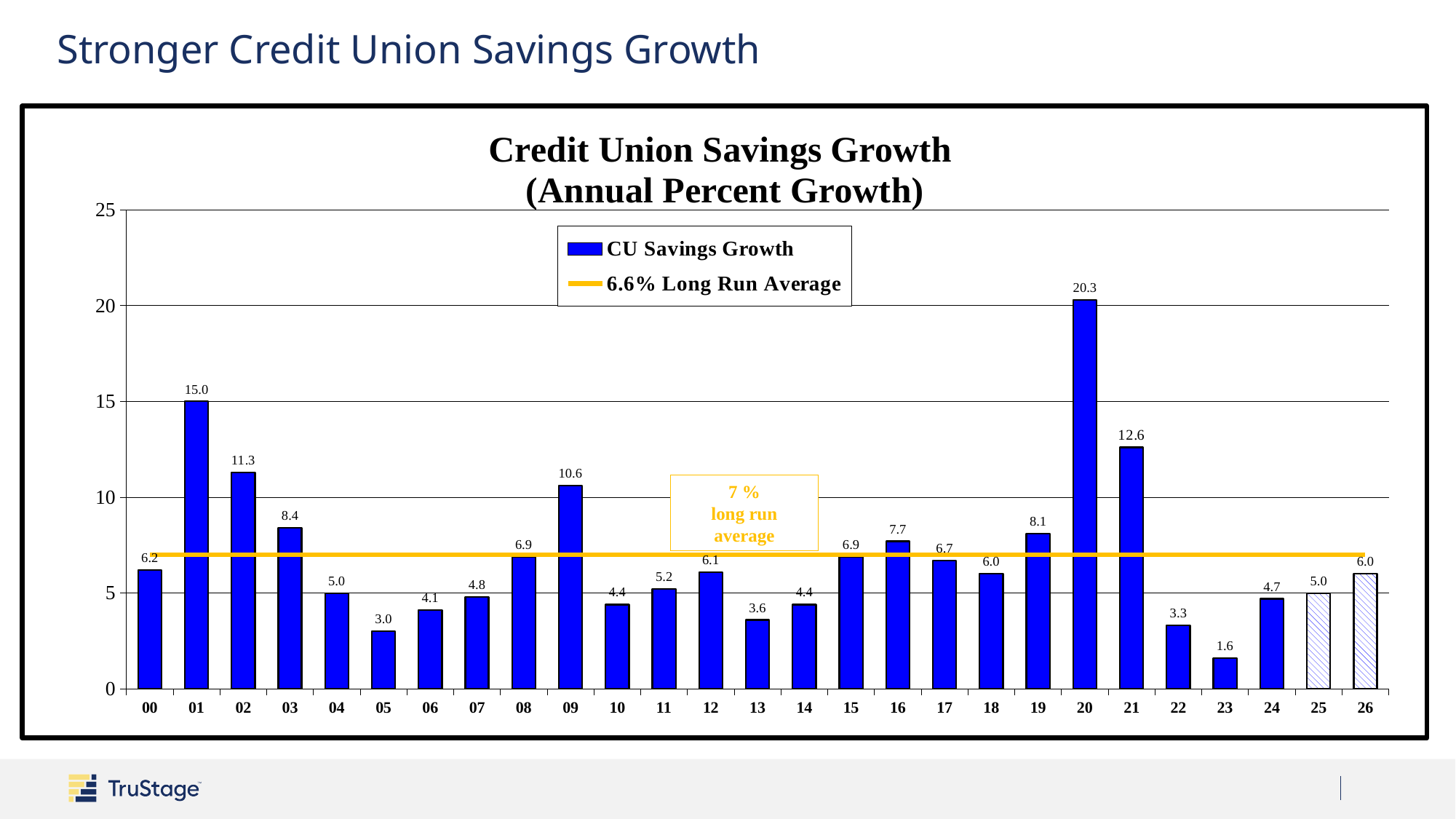
What is the difference between the CU Savings Growth values for 01 and 02? 3.7 How many series does the legend list? 2 Is the CU Savings Growth value for 21 greater or less than 10? greater What kind of chart is shown? combination bar and line chart What is the CU Savings Growth value for 09? 10.6 Which year has the highest CU Savings Growth? 20 What is the CU Savings Growth value for 23? 1.6 What is the CU Savings Growth value for 20? 20.3 What long run average does the legend give for the yellow line? 6.6% Which is larger, the CU Savings Growth value for 03 or for 19? 03 Which year has the lowest CU Savings Growth? 23 How many years are shown on the x axis? 27